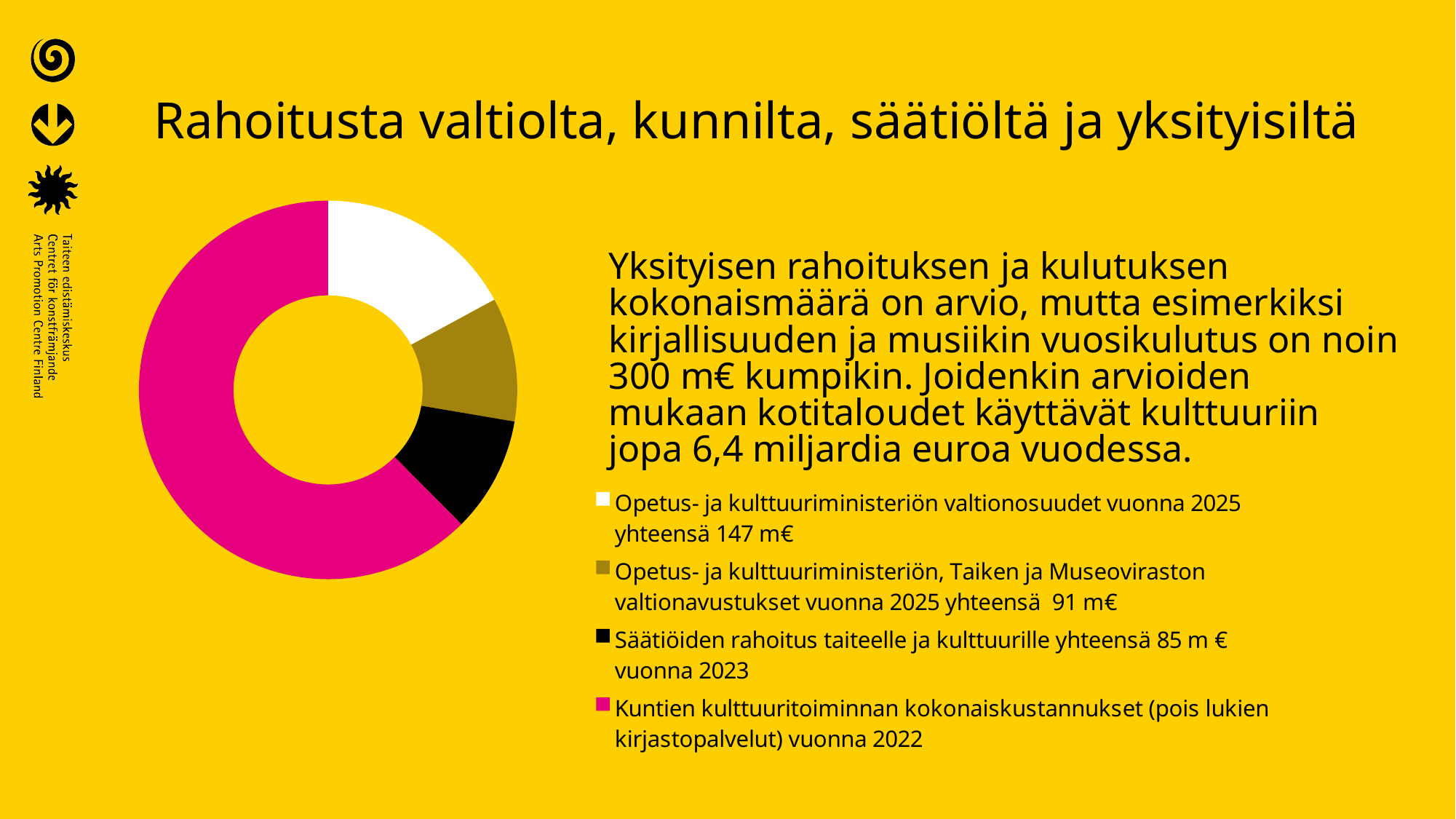
What is the value given for Opetus- ja kulttuuriministeriön, Taiken ja Museoviraston valtionavustukset vuonna 2025? 91 m€ What is the value given for Opetus- ja kulttuuriministeriön valtionosuudet vuonna 2025? 147 m€ What kind of chart is shown on the slide? Pie chart (donut) What is the value given for Säätiöiden rahoitus taiteelle ja kulttuurille vuonna 2023? 85 m € How many slices does the donut chart have? 4 Which is larger: the slice for Opetus- ja kulttuuriministeriön valtionosuudet (147 m€) or the slice for Säätiöiden rahoitus (85 m €)? Opetus- ja kulttuuriministeriön valtionosuudet Which category takes up the largest slice of the donut chart? Kuntien kulttuuritoiminnan kokonaiskustannukset (pois lukien kirjastopalvelut) vuonna 2022 What is the title of the slide containing the chart? Rahoitusta valtiolta, kunnilta, säätiöltä ja yksityisiltä What colour is the slice for Kuntien kulttuuritoiminnan kokonaiskustannukset? Magenta (pink) How many entries does the legend list? 4 What is the difference between the valtionosuudet value (147 m€) and the valtionavustukset value (91 m€)? 56 m€ Which category takes up the smallest slice of the donut chart? Säätiöiden rahoitus taiteelle ja kulttuurille vuonna 2023